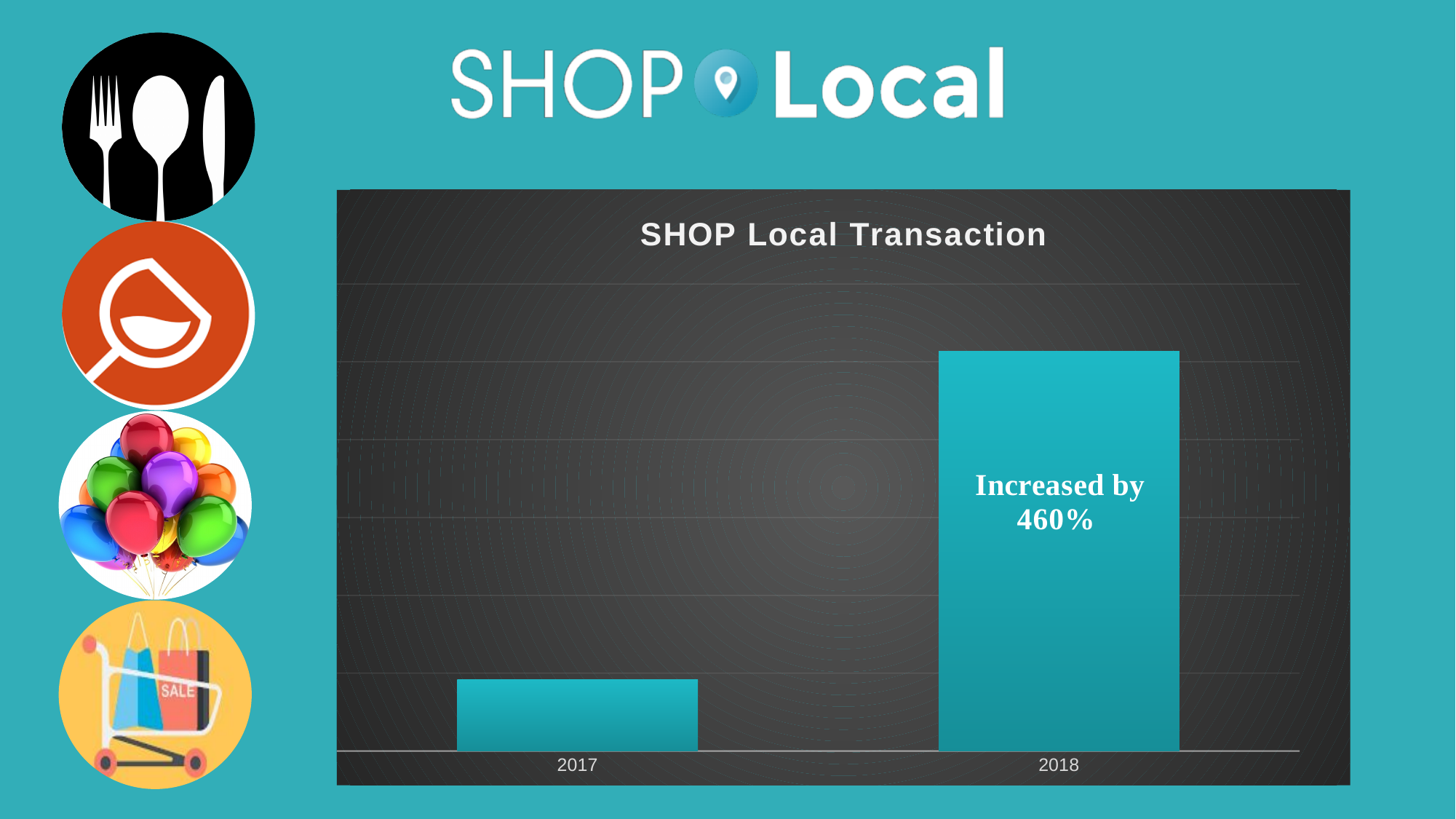
How many categories are plotted on the x axis of the chart? 2 Do the values rise or fall from 2017 to 2018? rise Which bar is taller, 2017 or 2018? 2018 What is the title of the chart? SHOP Local Transaction Which year has the highest bar in the chart? 2018 What are the two categories shown on the x axis? 2017 and 2018 Which year has the lowest bar in the chart? 2017 What text is written on the 2018 bar? Increased by 460% What kind of chart is shown on the slide? bar chart